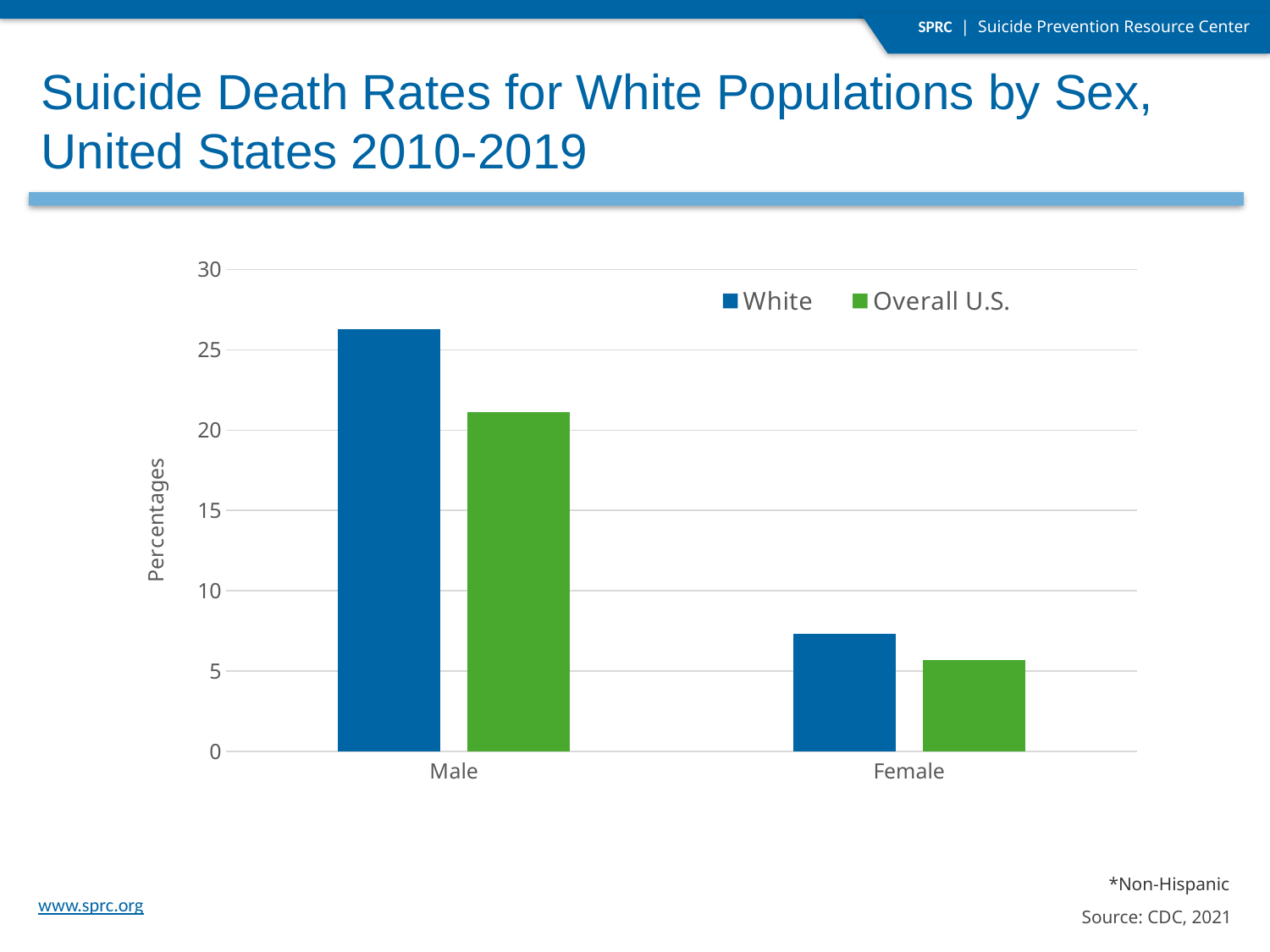
What kind of chart is shown on the slide? bar chart Is the White value for Male greater or less than 25? greater What is the label of the y axis? Percentages Is the Overall U.S. value for Female greater or less than 5? greater Is the Overall U.S. value for Male greater or less than 20? greater Which category has the lowest Overall U.S. bar? Female Which category has the highest White bar? Male How many series does the legend list? 2 How many categories are shown on the x axis? 2 For Male, which is larger: the White value or the Overall U.S. value? White Which series is shown in green in the legend? Overall U.S.